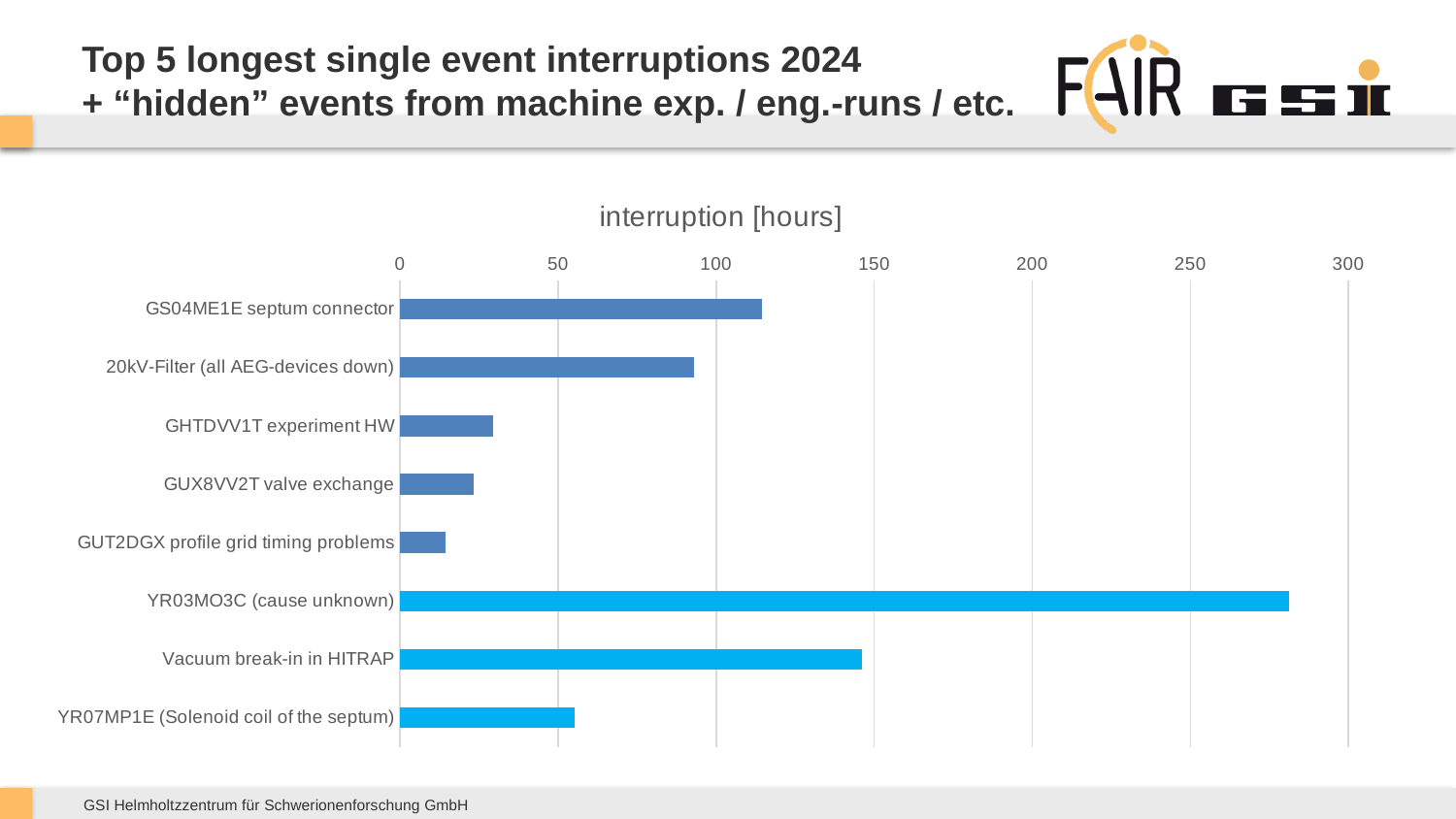
Is the interruption for Vacuum break-in in HITRAP greater or less than 100 hours? greater Which has the longer interruption: GS04ME1E septum connector or 20kV-Filter (all AEG-devices down)? GS04ME1E septum connector What kind of chart is shown on the slide? bar chart Is the interruption for GUT2DGX profile grid timing problems greater or less than 50 hours? less Is the interruption for YR03MO3C (cause unknown) greater or less than 250 hours? greater Which has the longer interruption: YR07MP1E (Solenoid coil of the septum) or GHTDVV1T experiment HW? YR07MP1E (Solenoid coil of the septum) What is the title of the chart? interruption [hours] Which event has the shortest interruption in the chart? GUT2DGX profile grid timing problems Which event has the longest interruption in the chart? YR03MO3C (cause unknown) How many categories (events) are plotted in the chart? 8